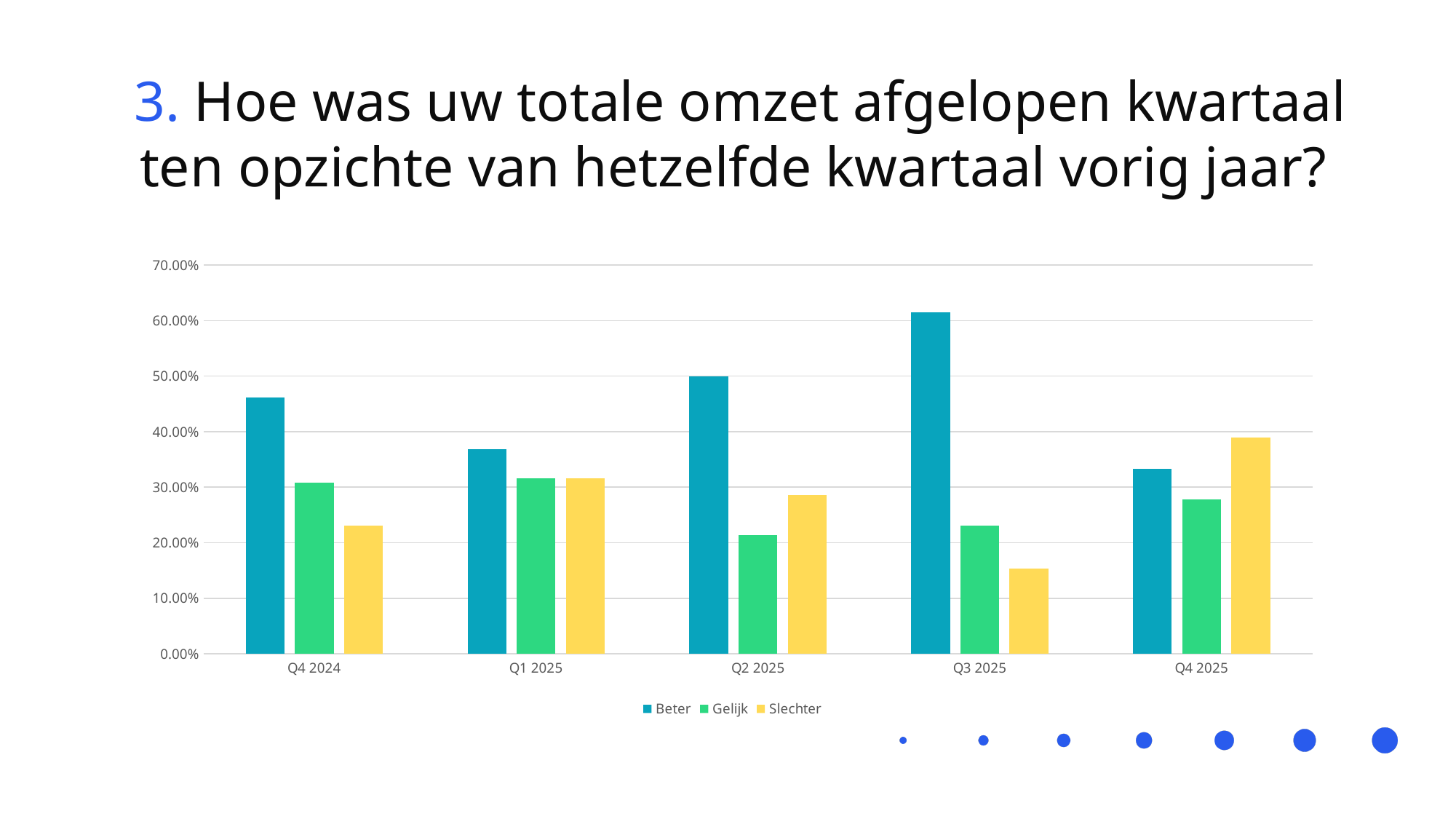
In Q4 2024, which is larger: 'Beter' or 'Gelijk'? Beter In Q4 2025, which is larger: 'Beter' or 'Slechter'? Slechter In which quarter is the 'Beter' bar the highest? Q3 2025 How many quarters are shown on the x axis? 5 In which quarter is the 'Slechter' bar the lowest? Q3 2025 What kind of chart is shown on the slide? Bar chart In which quarter is the 'Slechter' bar the highest? Q4 2025 What are the three entries in the legend? Beter, Gelijk, Slechter Is the value for 'Slechter' in Q3 2025 greater or less than 20.00%? less Is the value for 'Beter' in Q3 2025 greater or less than 50.00%? greater Is the value for 'Gelijk' in Q2 2025 greater or less than 30.00%? less How many series does the legend list? 3